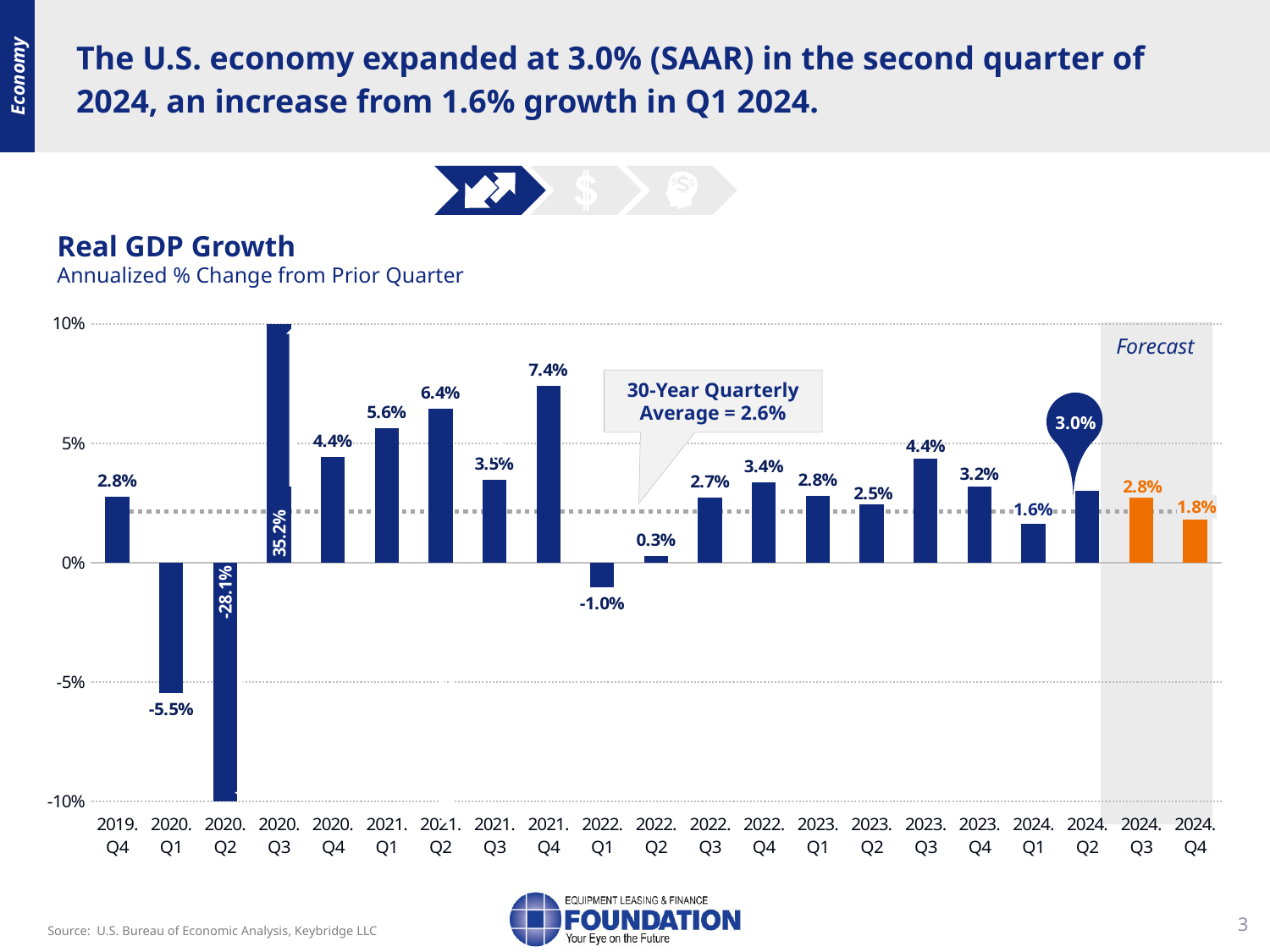
Which is larger in the Real GDP Growth chart, the value for 2021 Q4 or the value for 2021 Q2? 2021 Q4 What kind of chart is the Real GDP Growth chart? Bar chart What is the value for 2024 Q2 in the Real GDP Growth chart? 3.0% What is the 30-year quarterly average shown in the Real GDP Growth chart? 2.6% How many quarters are plotted in the Real GDP Growth chart? 21 What is the value for 2022 Q1 in the Real GDP Growth chart? -1.0% Which quarters are marked as Forecast in the Real GDP Growth chart? 2024 Q3 and 2024 Q4 Which quarter has the lowest value in the Real GDP Growth chart? 2020 Q2 What is the value for 2020 Q2 in the Real GDP Growth chart? -28.1% What is the forecast value for 2024 Q4 in the Real GDP Growth chart? 1.8% Which quarter has the highest value in the Real GDP Growth chart? 2020 Q3 What is the difference between the values for 2024 Q2 and 2024 Q1 in the Real GDP Growth chart? 1.4 percentage points